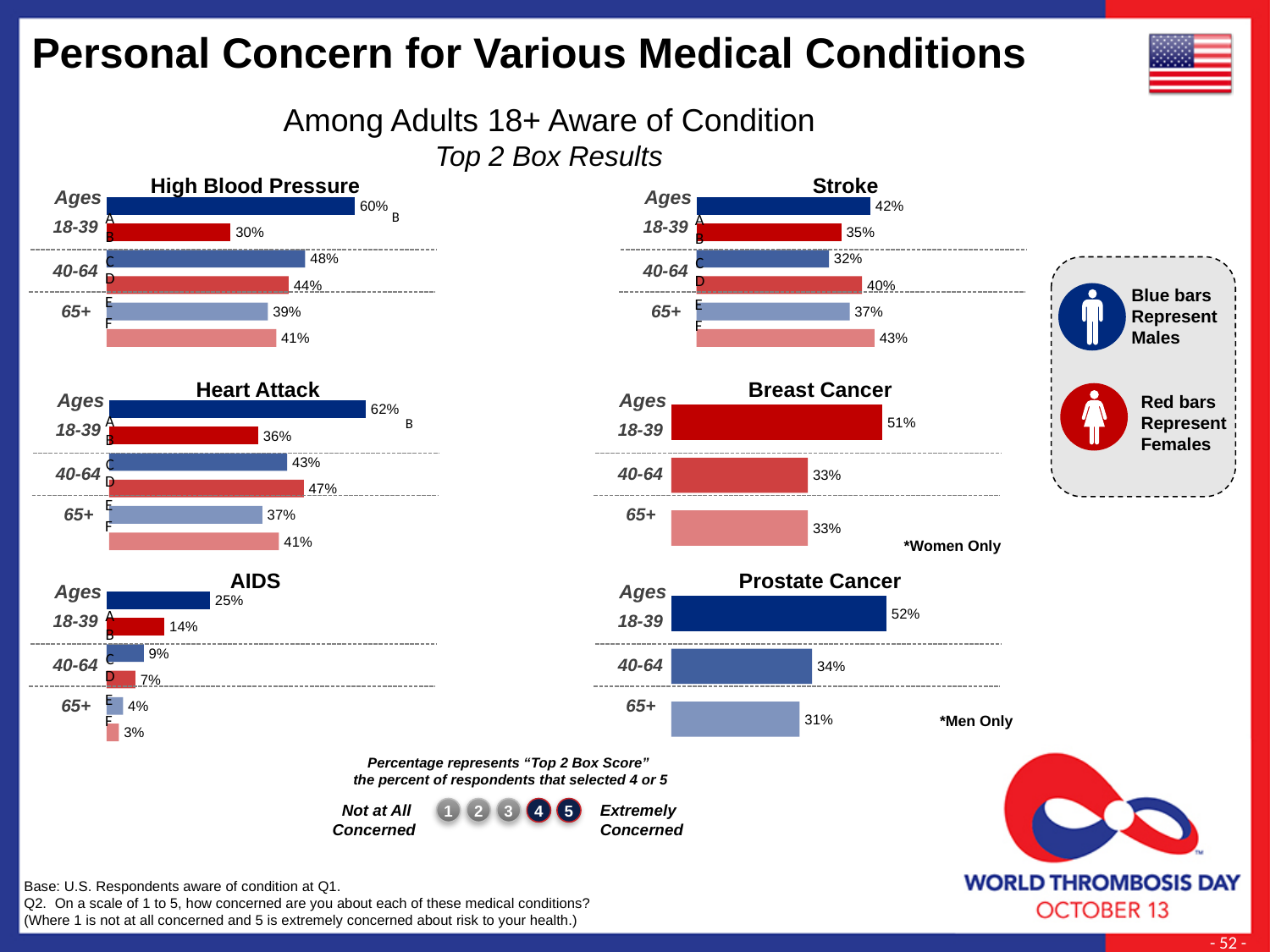
In the Prostate Cancer chart, do the values rise or fall as age increases? Fall In the Stroke chart, which is larger for ages 65+, the male value or the female value? Female value In the Heart Attack chart, what is the value for females aged 40-64? 47% In the Prostate Cancer chart, what is the difference between the 18-39 and 65+ values? 21% In the Breast Cancer chart, what is the value for ages 18-39? 51% In the High Blood Pressure chart, what is the value for males aged 18-39? 60% In the AIDS chart, what is the value for females aged 18-39? 14% In the High Blood Pressure chart, what is the difference between males and females aged 18-39? 30% In the Heart Attack chart, which group has the highest value? Males 18-39 What type of chart is used for the Heart Attack data? Bar chart In the Stroke chart, what is the value for males aged 40-64? 32% In the AIDS chart, which group has the lowest value? Females 65+